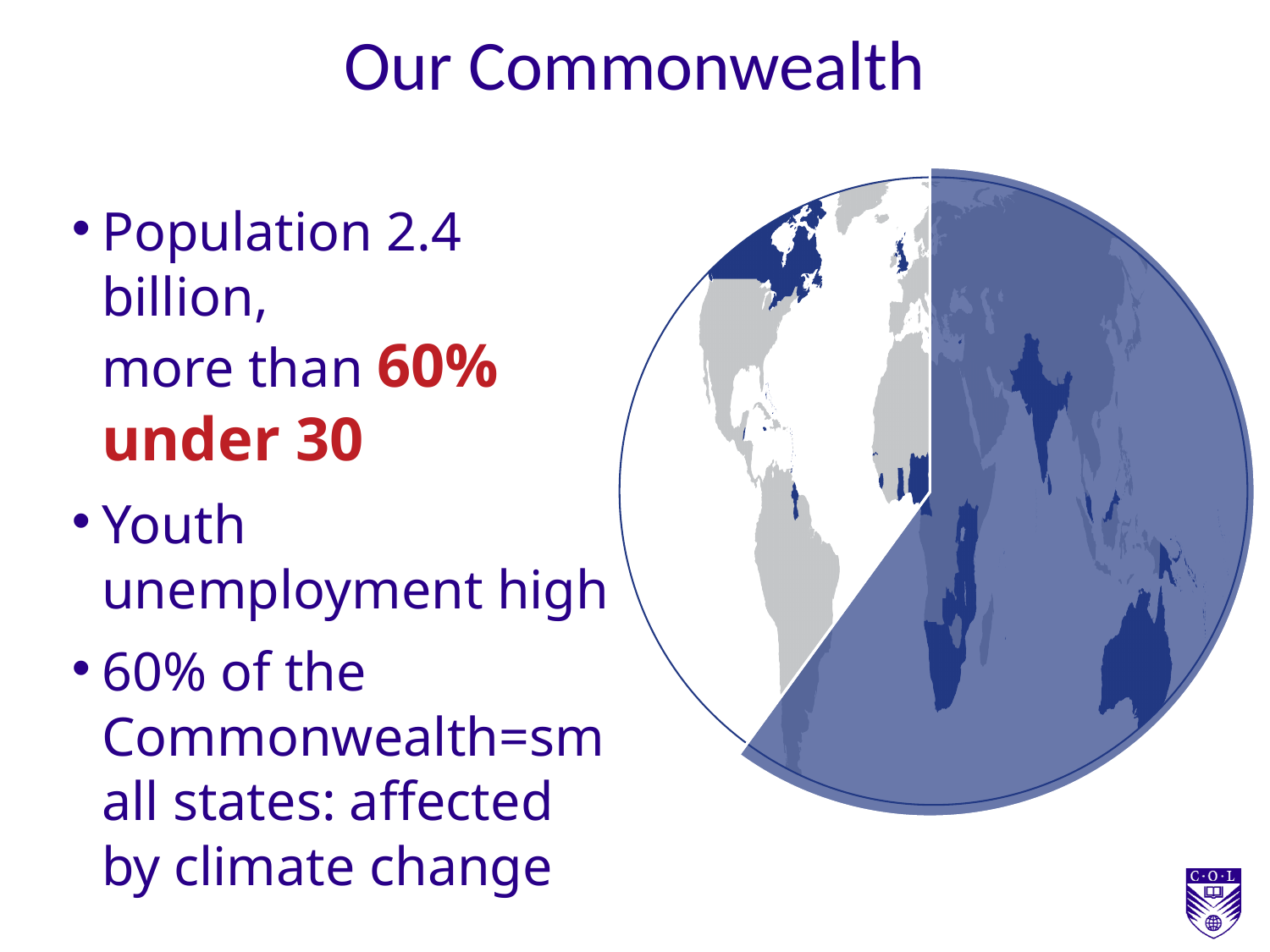
Which slice of the pie chart is larger, the blue shaded slice or the unshaded slice? the blue shaded slice What is the title of the slide containing the pie chart? Our Commonwealth What kind of chart is shown on the slide? pie chart Is the blue shaded slice of the pie chart greater or less than half of the pie? greater What image is shown behind the pie chart? a world map How many slices does the pie chart have? 2